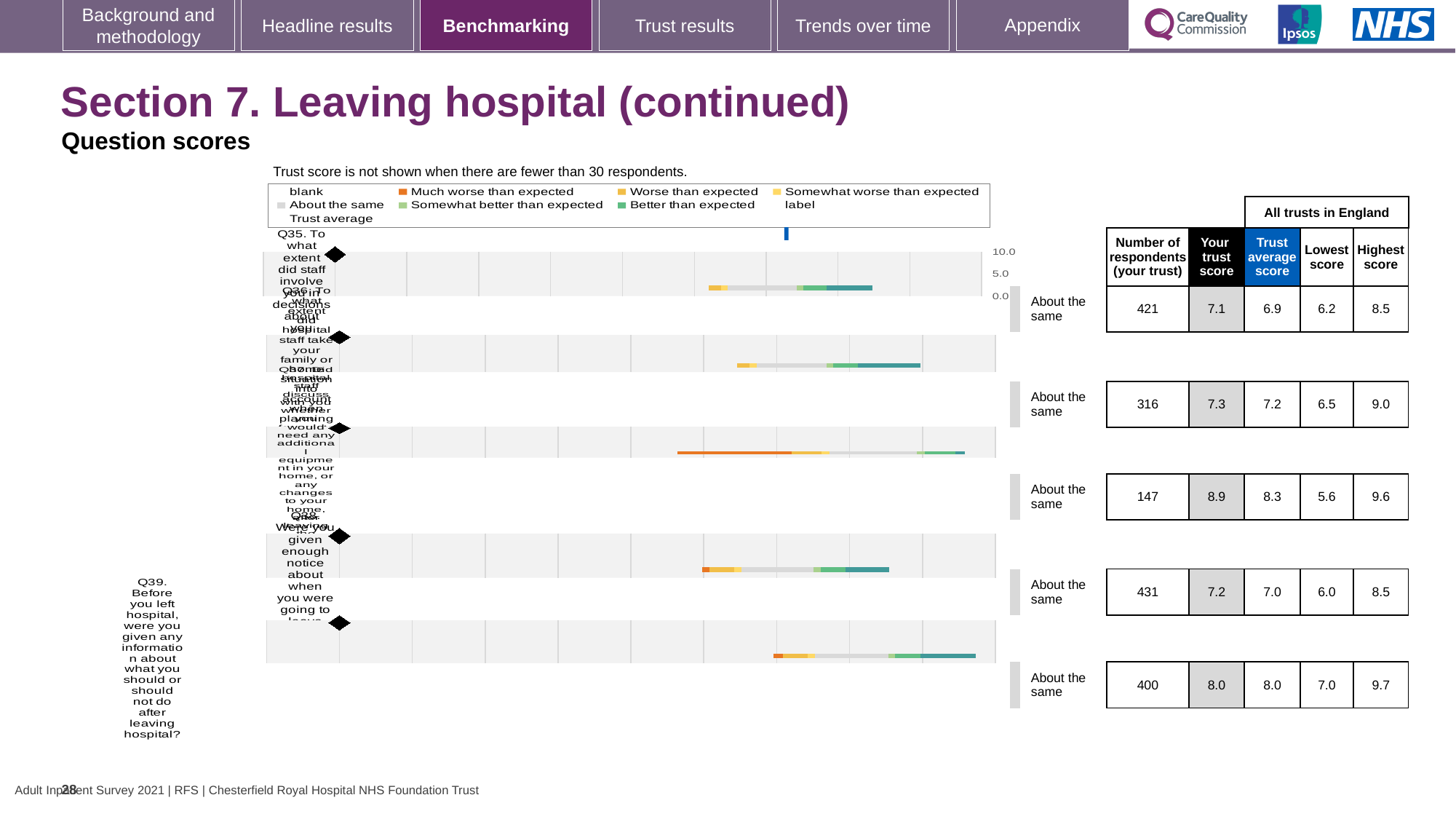
What is the number of respondents shown in the first row of the table (Q35)? 421 What is the highest score across all trusts in England for Q39? 9.7 How many question rows are shown in the table? 5 What kind of chart is used to show the question scores? bar chart Which question row has the highest 'Your trust score' in the table? 8.9 (third row) How many respondents does the table show for Q39? 400 Which question row has the fewest respondents in the table? 147 (third row) What is the trust average score in the first row of the table (Q35)? 6.9 What benchmark category is shown next to every question on this slide? About the same What is the trust score for Q39 (information about what you should or should not do after leaving hospital)? 8.0 What is the difference between the trust score and the trust average score in the third row (8.9 vs 8.3)? 0.6 Is the trust score in the fourth row (7.2) larger or smaller than the trust average score (7.0)? larger